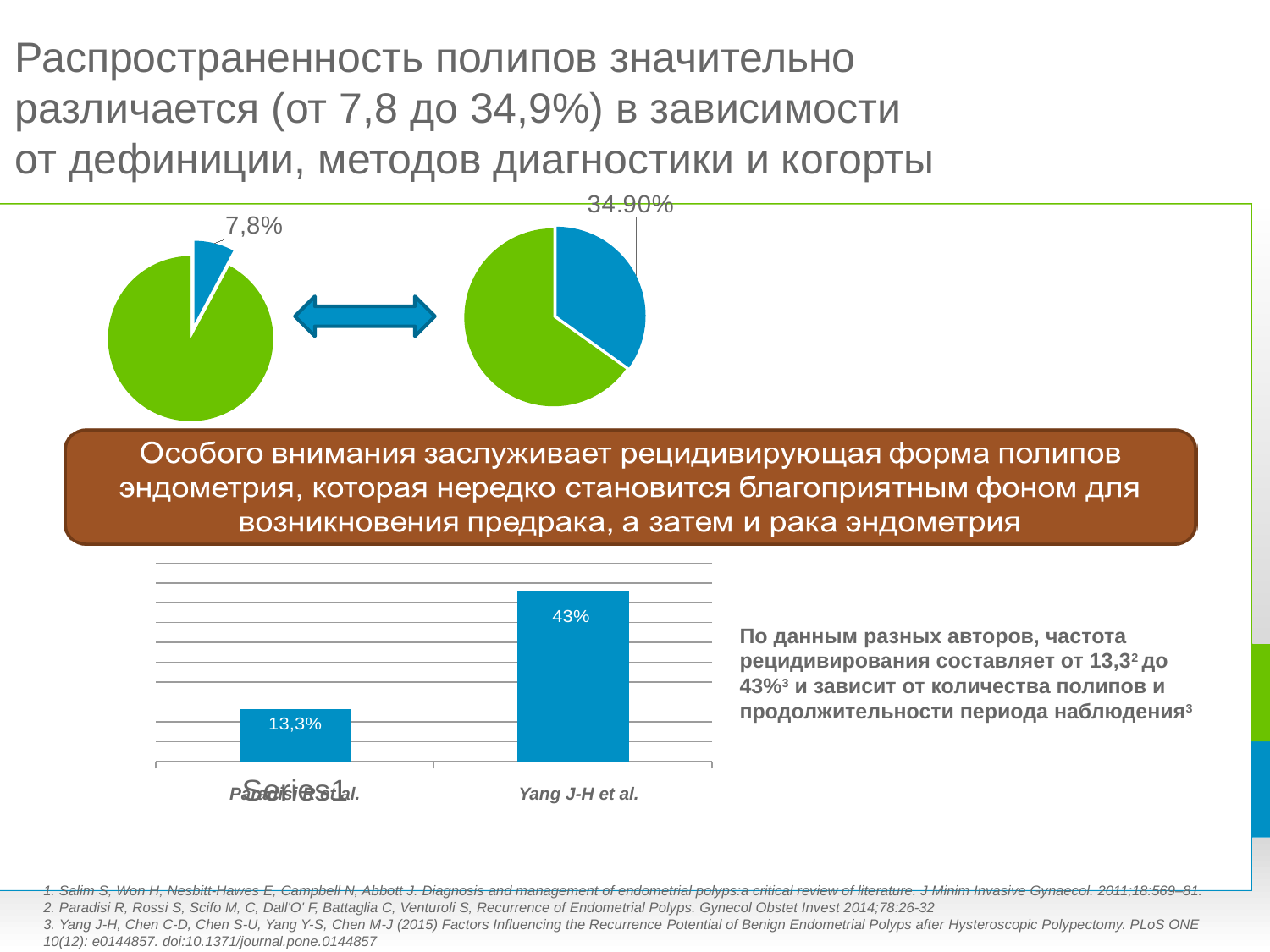
Which pie chart has the larger blue slice, the left one or the right one? The right one On the bar chart at the bottom of the slide, which category has the lowest value? Paradisi R et al. What kind of chart is shown at the bottom of the slide? Bar chart On the right pie chart, what is the value of the blue slice? 34.90% On the bar chart at the bottom of the slide, which is larger: the value for Paradisi R et al. or the value for Yang J-H et al.? Yang J-H et al. On the bar chart at the bottom of the slide, what is the value for Paradisi R et al.? 13,3% On the bar chart at the bottom of the slide, what is the value for Yang J-H et al.? 43% On the left pie chart, what is the value of the blue slice? 7,8% On the bar chart at the bottom of the slide, how many categories are shown? 2 What kind of charts are the two charts in the upper part of the slide? Pie charts On the bar chart at the bottom of the slide, which category has the highest value? Yang J-H et al.